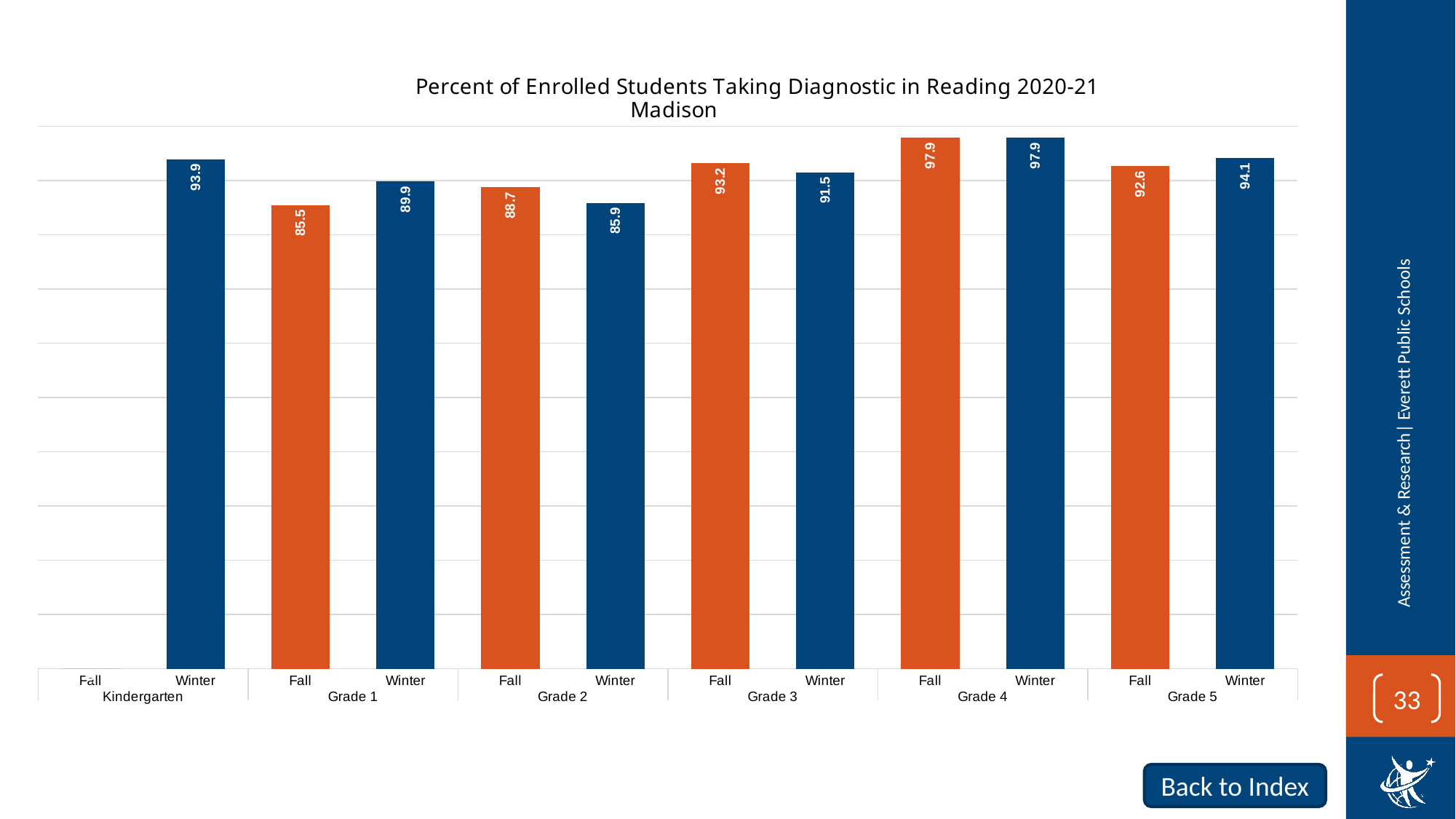
Which is larger for Grade 3, the Fall value or the Winter value? Fall Which school is named in the chart title? Madison What is the difference between the Winter and Fall values for Grade 1? 4.4 Which grade has the highest percentage of enrolled students taking the diagnostic? Grade 4 Which bar shows the lowest value on the chart? Grade 1 Fall (85.5) What is the Winter value for Kindergarten? 93.9 What is the Winter value for Grade 5? 94.1 What is the Fall value for Grade 4? 97.9 What is the Fall value for Grade 1? 85.5 What kind of chart is shown on the slide? Bar chart What is the Winter value for Grade 2? 85.9 How many grade levels are shown on the x axis? 6